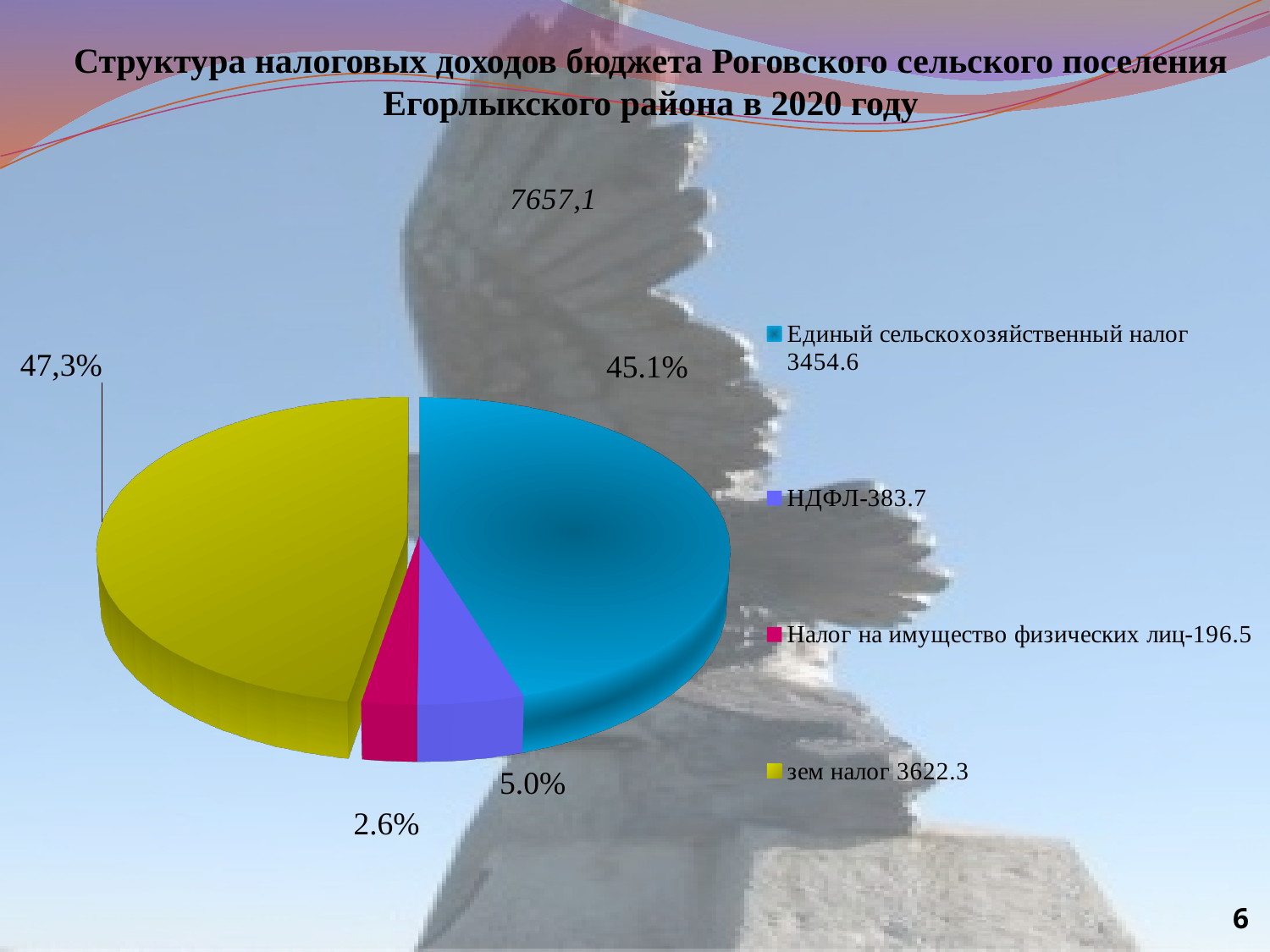
What percentage share is shown for the Налог на имущество физических лиц slice? 2.6% What colour is the slice for Единый сельскохозяйственный налог? blue What percentage share is shown for the зем налог slice? 47,3% How many entries does the legend list? 4 What percentage share is shown for the НДФЛ slice? 5.0% Which is larger, the share for НДФЛ or the share for Налог на имущество физических лиц? НДФЛ Which slice of the pie chart is the smallest? Налог на имущество физических лиц What value is given in the legend for НДФЛ? 383.7 How many slices does the pie chart have? 4 What kind of chart is shown on the slide? pie chart Which slice of the pie chart is the largest? зем налог